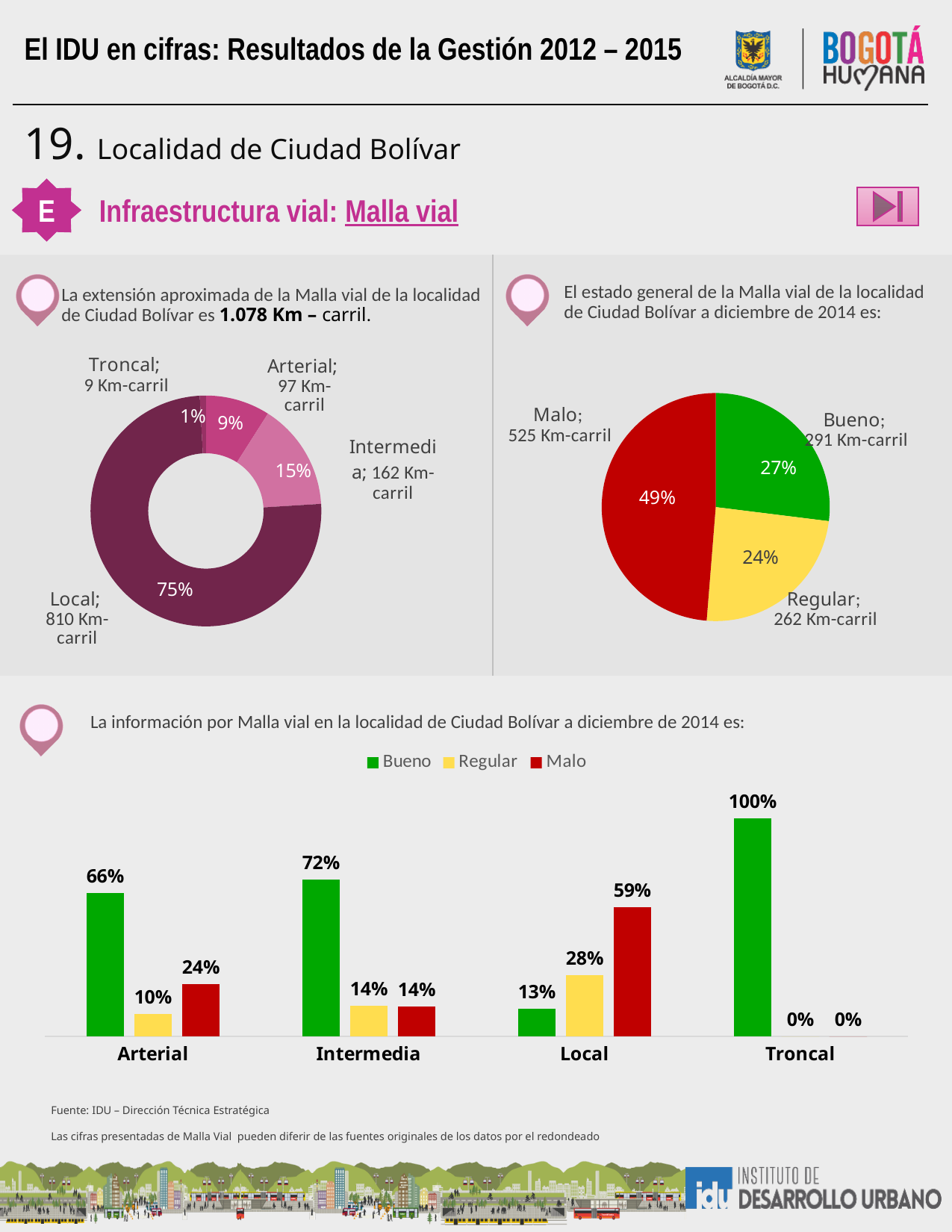
In the bar chart at the bottom, what is the Malo value for Local? 59% In the bar chart at the bottom, what is the difference between the Malo values for Arterial and Intermedia? 10% In the bar chart at the bottom, which category has the highest Bueno value? Troncal In the bar chart at the bottom, how many series does the legend list? 3 In the pie chart on the right, what is the difference in Km-carril between Malo and Bueno? 234 Km-carril In the donut chart on the left, what share of the Malla vial is Local? 75% In the bar chart at the bottom, what is the Bueno value for Intermedia? 72% In the donut chart on the left, how many Km-carril does Arterial account for? 97 Km-carril In the pie chart on the right, what share of the Malla vial is in Malo state? 49% In the pie chart on the right, how many Km-carril are in Regular state? 262 Km-carril What kind of chart is shown at the bottom of the slide? Bar chart In the donut chart on the left, which category has the smallest share? Troncal